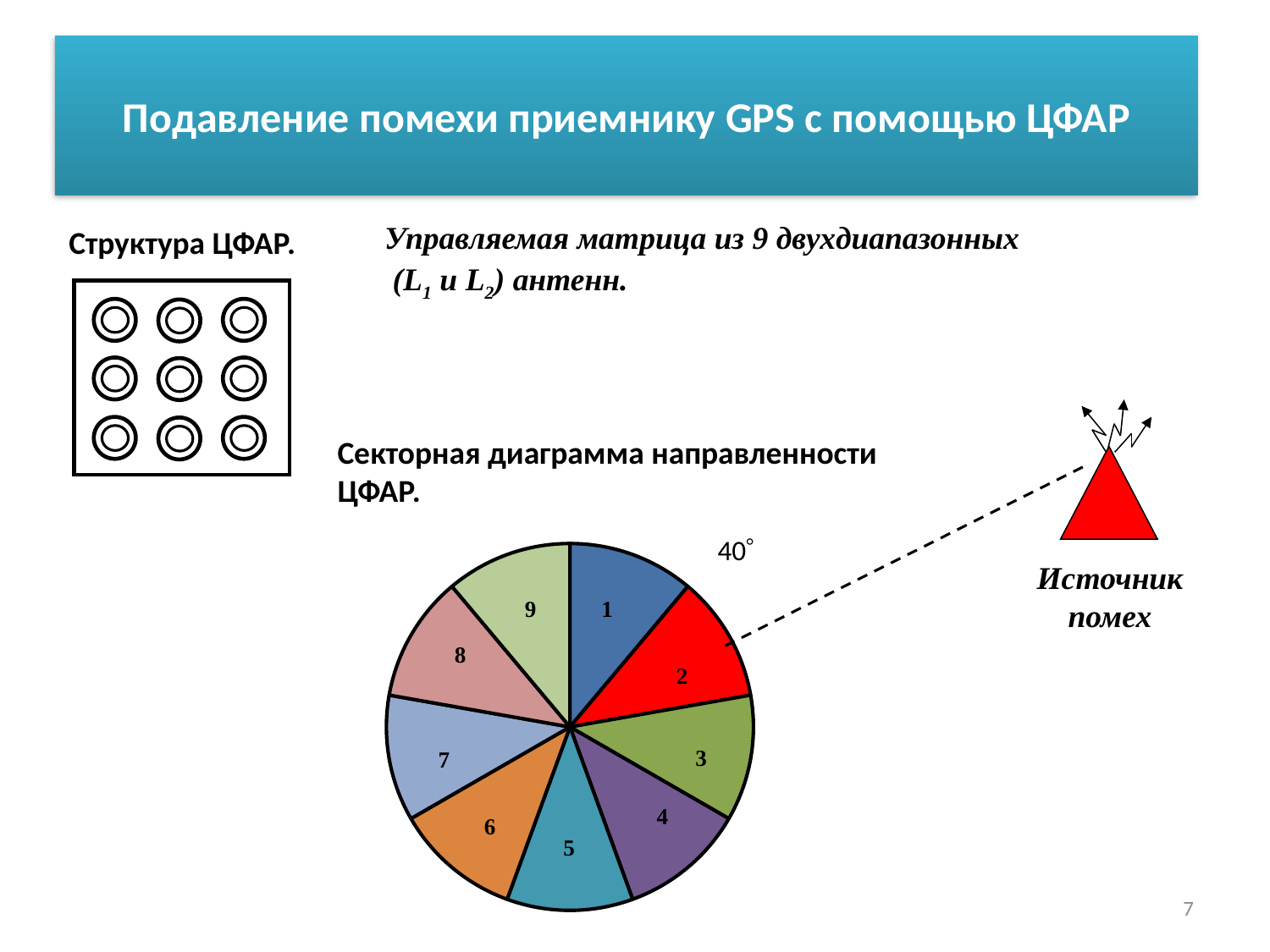
What is the lowest sector number shown in the directivity diagram? 1 What angle is labeled next to the sector directivity diagram? 40° What is the highest sector number shown in the directivity diagram? 9 How many sectors are shown in the sector directivity diagram? 9 Which sector of the directivity diagram is highlighted in red? 2 What is the title given to the pie chart on the slide? Секторная диаграмма направленности ЦФАР. What is the label of the sector that the dashed line from the interference source points to? 2 What kind of chart is the sector directivity diagram on the slide? pie chart